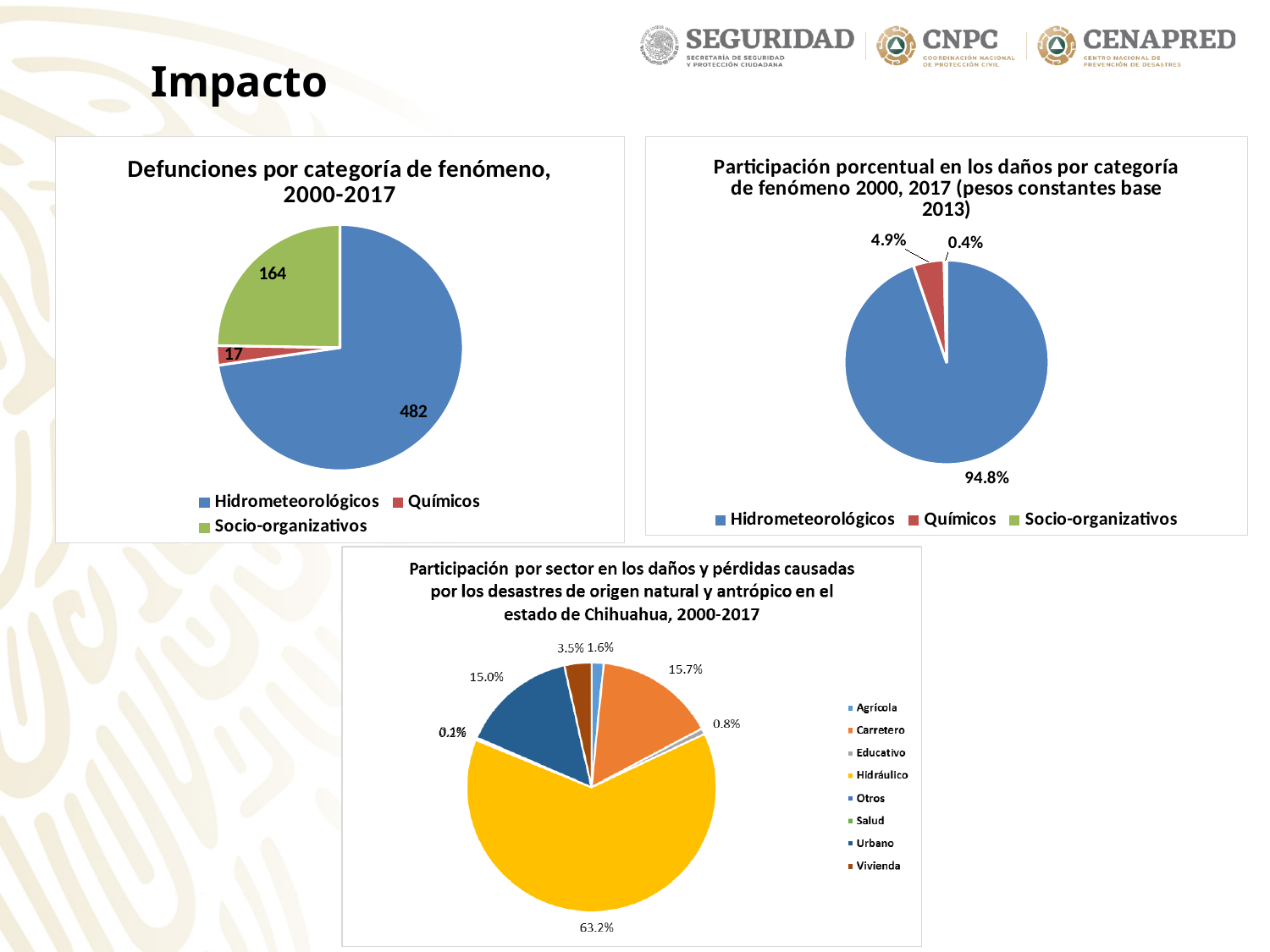
In the chart 'Participación porcentual en los daños por categoría de fenómeno 2000, 2017', how many categories does the legend list? 3 In the chart 'Participación por sector en los daños y pérdidas... estado de Chihuahua, 2000-2017', what share corresponds to the Hidráulico sector? 63.2% In the chart 'Participación por sector en los daños y pérdidas... estado de Chihuahua, 2000-2017', how many sectors does the legend list? 8 In the chart 'Defunciones por categoría de fenómeno, 2000-2017', how many deaths are attributed to Hidrometeorológicos? 482 In the chart 'Participación porcentual en los daños por categoría de fenómeno 2000, 2017', which category has the largest share? Hidrometeorológicos In the chart 'Defunciones por categoría de fenómeno, 2000-2017', which category has the fewest deaths? Químicos In the chart 'Defunciones por categoría de fenómeno, 2000-2017', how many deaths are attributed to Socio-organizativos? 164 In the chart 'Defunciones por categoría de fenómeno, 2000-2017', what is the total number of deaths across all three categories? 663 What type of chart is used for 'Defunciones por categoría de fenómeno, 2000-2017'? Pie chart In the chart 'Defunciones por categoría de fenómeno, 2000-2017', what is the difference between the deaths for Hidrometeorológicos and Socio-organizativos? 318 In the chart 'Participación por sector en los daños y pérdidas... estado de Chihuahua, 2000-2017', which is larger, the share for Carretero or the share for Vivienda? Carretero In the chart 'Participación porcentual en los daños por categoría de fenómeno 2000, 2017', what share of damages corresponds to Químicos? 4.9%